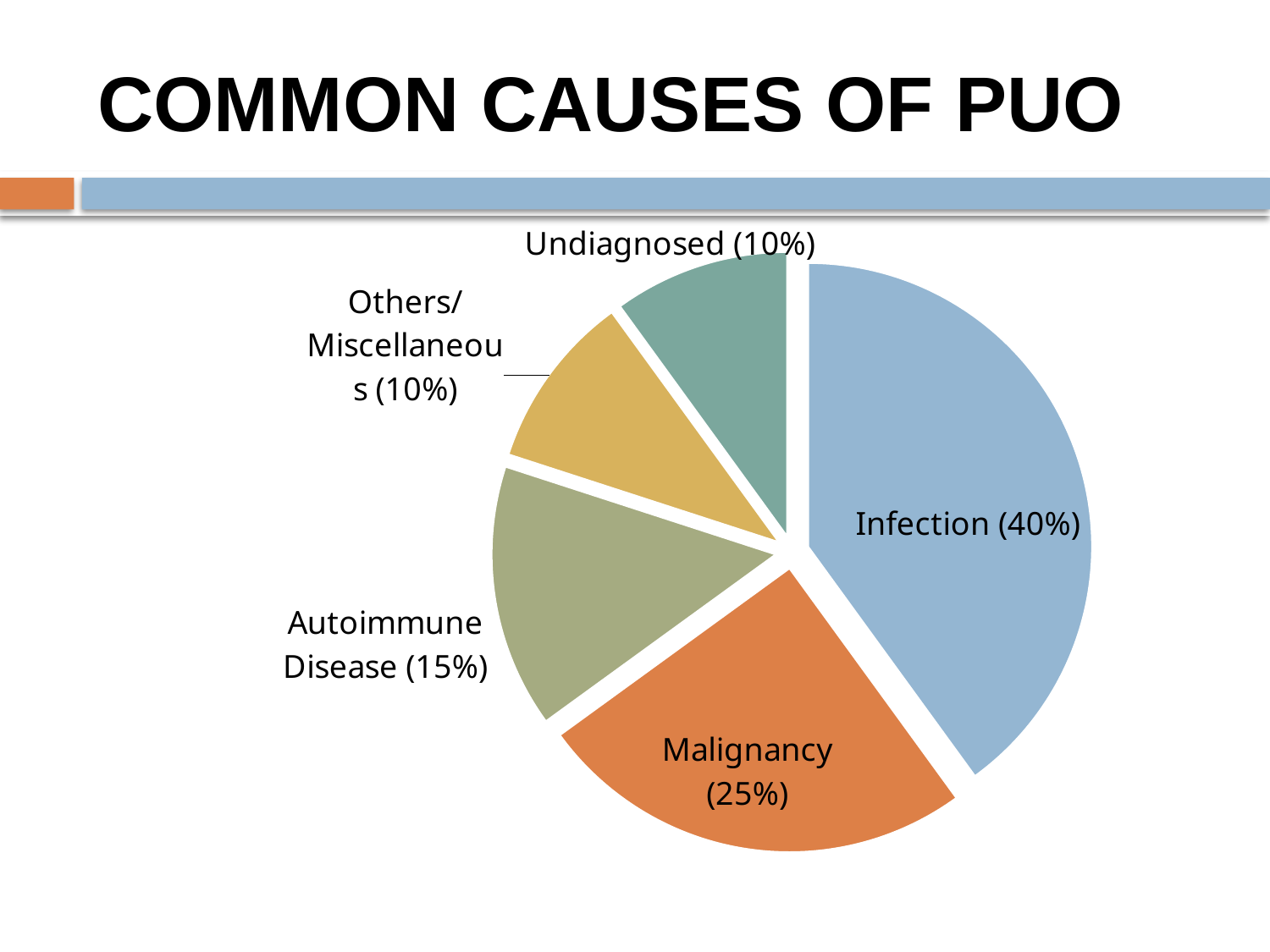
What colour is the Malignancy slice? orange How many slices does the pie chart have? 5 Which category has the largest slice of the pie? Infection What is the difference in percentage points between Autoimmune Disease and Undiagnosed? 5 Which is larger, the share for Malignancy or the share for Autoimmune Disease? Malignancy What is the title of the slide containing the pie chart? COMMON CAUSES OF PUO What share of the pie does Infection account for? 40% What share of the pie does Undiagnosed account for? 10% What share of the pie does Autoimmune Disease account for? 15% What kind of chart is shown on the slide? pie chart What is the difference in percentage points between Infection and Malignancy? 15